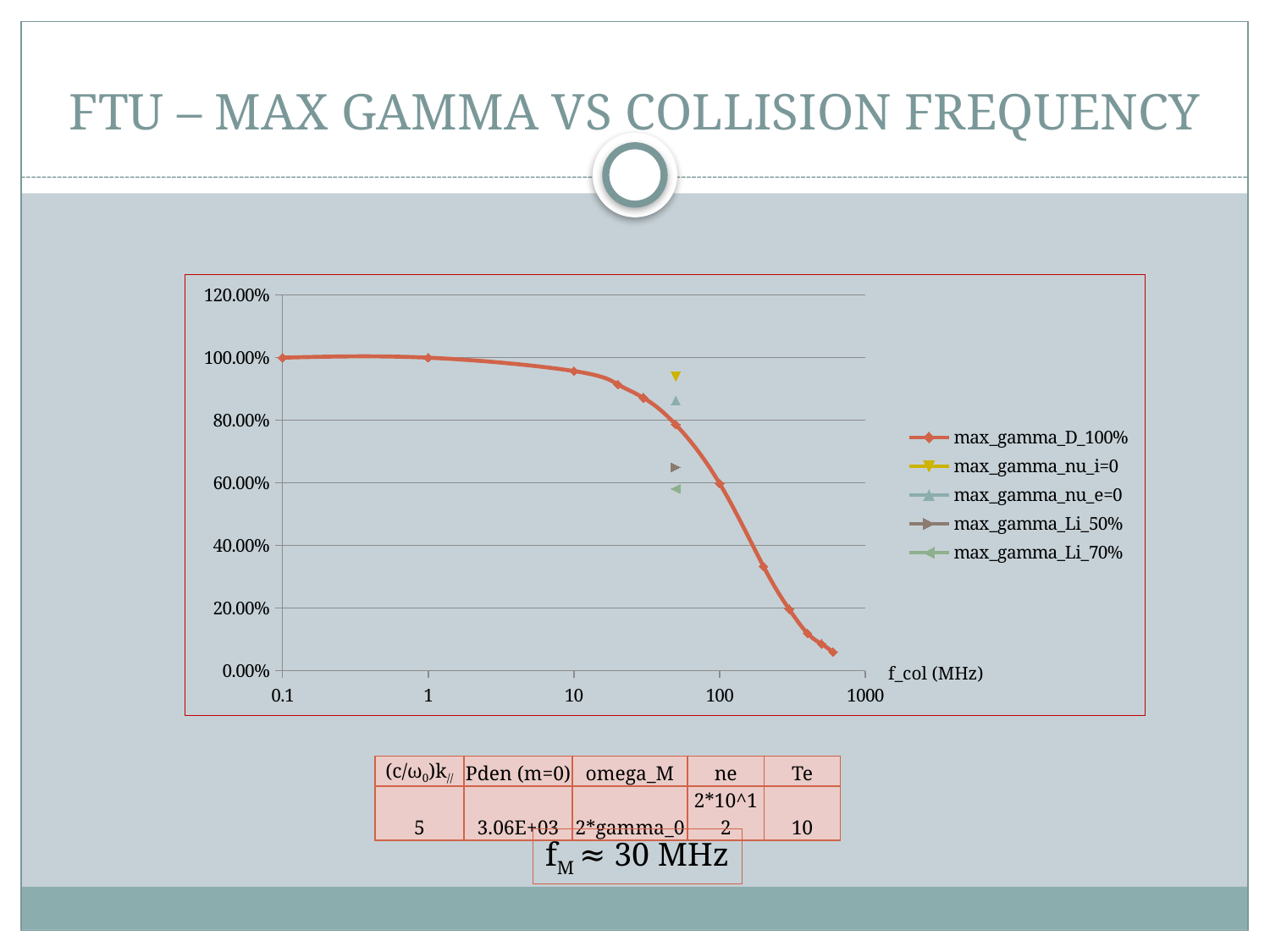
Is the value of max_gamma_D_100% at f_col = 1 MHz greater or less than 80.00%? greater Which is larger, the plotted value for max_gamma_nu_i=0 or for max_gamma_Li_50%? max_gamma_nu_i=0 What is the label on the x axis of the chart? f_col (MHz) Is the value of max_gamma_D_100% at f_col = 100 MHz greater or less than 80.00%? less Which is larger, the plotted value for max_gamma_nu_e=0 or for max_gamma_Li_70%? max_gamma_nu_e=0 Among the four single-point series (max_gamma_nu_i=0, max_gamma_nu_e=0, max_gamma_Li_50%, max_gamma_Li_70%), which has the lowest plotted value? max_gamma_Li_70% Is the plotted value for max_gamma_nu_i=0 greater or less than 80.00%? greater How many series does the chart legend list? 5 What kind of chart is shown on the slide? line chart Does the max_gamma_D_100% series rise or fall as f_col increases along the x axis? fall